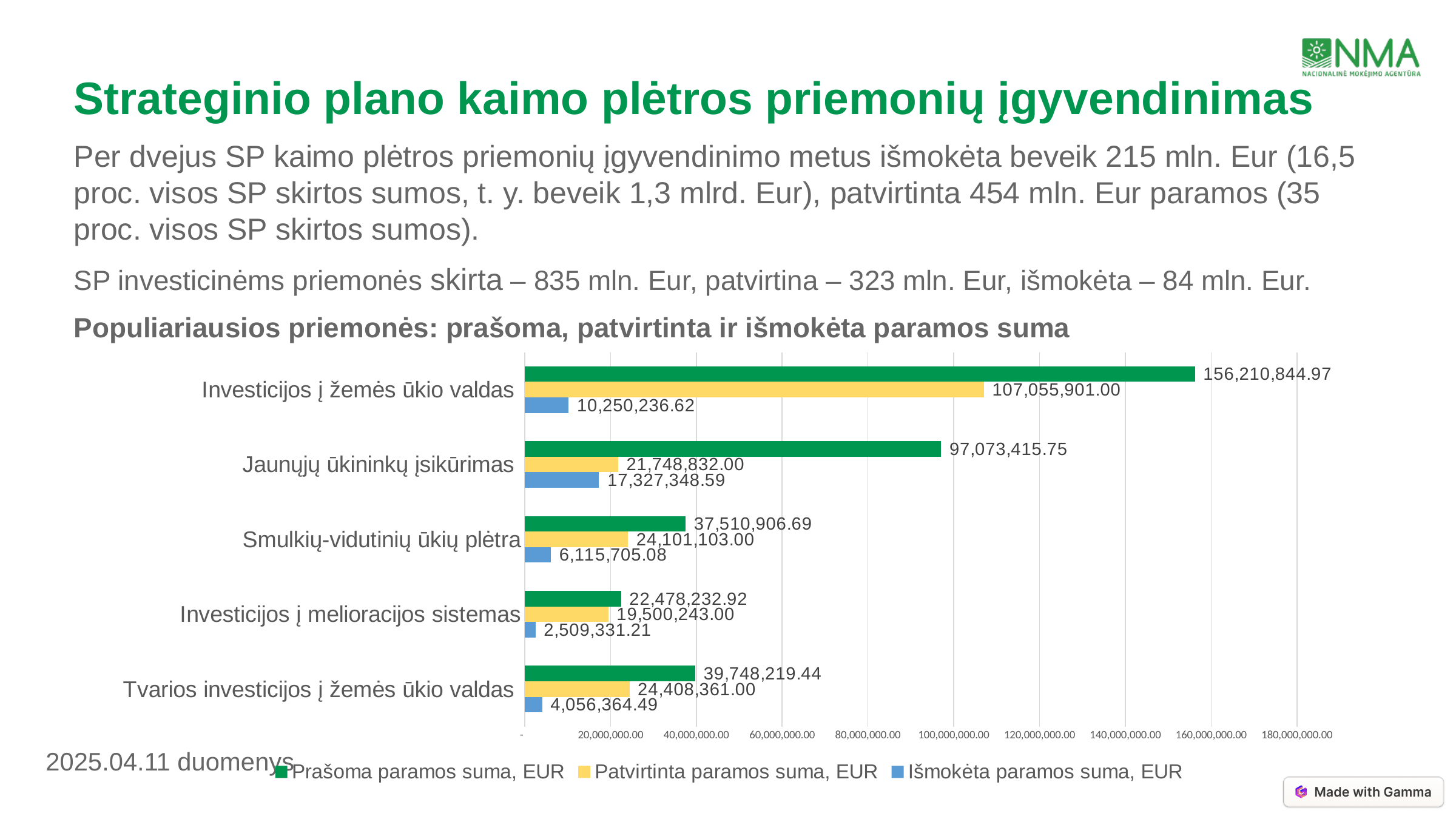
What is the Išmokėta paramos suma, EUR for Jaunųjų ūkininkų įsikūrimas? 17,327,348.59 Is the Prašoma paramos suma for Jaunųjų ūkininkų įsikūrimas greater or less than 80,000,000.00? greater Which is larger: the Prašoma paramos suma for Smulkių-vidutinių ūkių plėtra or for Tvarios investicijos į žemės ūkio valdas? Tvarios investicijos į žemės ūkio valdas What is the Prašoma paramos suma, EUR for Investicijos į žemės ūkio valdas? 156,210,844.97 Which colour represents the Išmokėta paramos suma, EUR series in the chart? Blue What is the Patvirtinta paramos suma, EUR for Tvarios investicijos į žemės ūkio valdas? 24,408,361.00 Which category has the lowest Išmokėta paramos suma, EUR? Investicijos į melioracijos sistemas Which category has the highest Prašoma paramos suma, EUR? Investicijos į žemės ūkio valdas How many series does the chart legend list? 3 What type of chart is shown on the slide? Bar chart How many categories (priemonės) are shown in the chart? 5 What is the difference between the Prašoma and Patvirtinta paramos suma for Investicijos į žemės ūkio valdas? 49,154,943.97